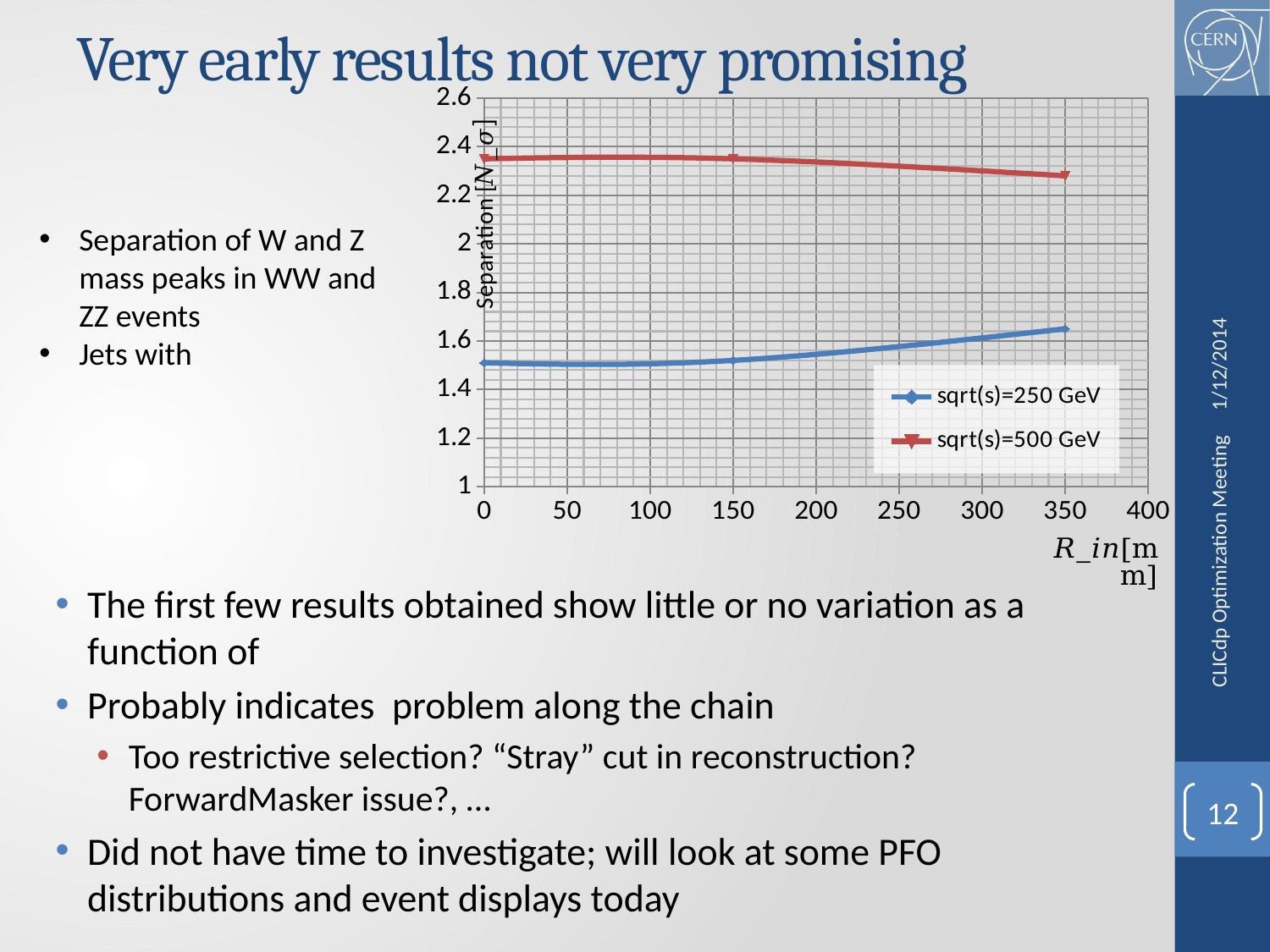
Does the sqrt(s)=500 GeV series rise or fall as R_in increases from 0 to 350 mm? falls Is the separation for sqrt(s)=500 GeV at R_in = 0 mm greater or less than 2.2? greater Is the separation for sqrt(s)=250 GeV at R_in = 350 mm greater or less than 1.6? greater What kind of chart is shown on the slide? line chart Which colour is used for the sqrt(s)=500 GeV series? red Does the sqrt(s)=250 GeV series rise or fall as R_in increases from 0 to 350 mm? rises How many data points are plotted for the sqrt(s)=250 GeV series? 3 What is the label of the chart's y axis? Separation [N σ] How many series does the chart legend list? 2 Is the separation for sqrt(s)=250 GeV at R_in = 0 mm greater or less than 1.4? greater Which series has the higher separation at R_in = 0 mm, sqrt(s)=250 GeV or sqrt(s)=500 GeV? sqrt(s)=500 GeV